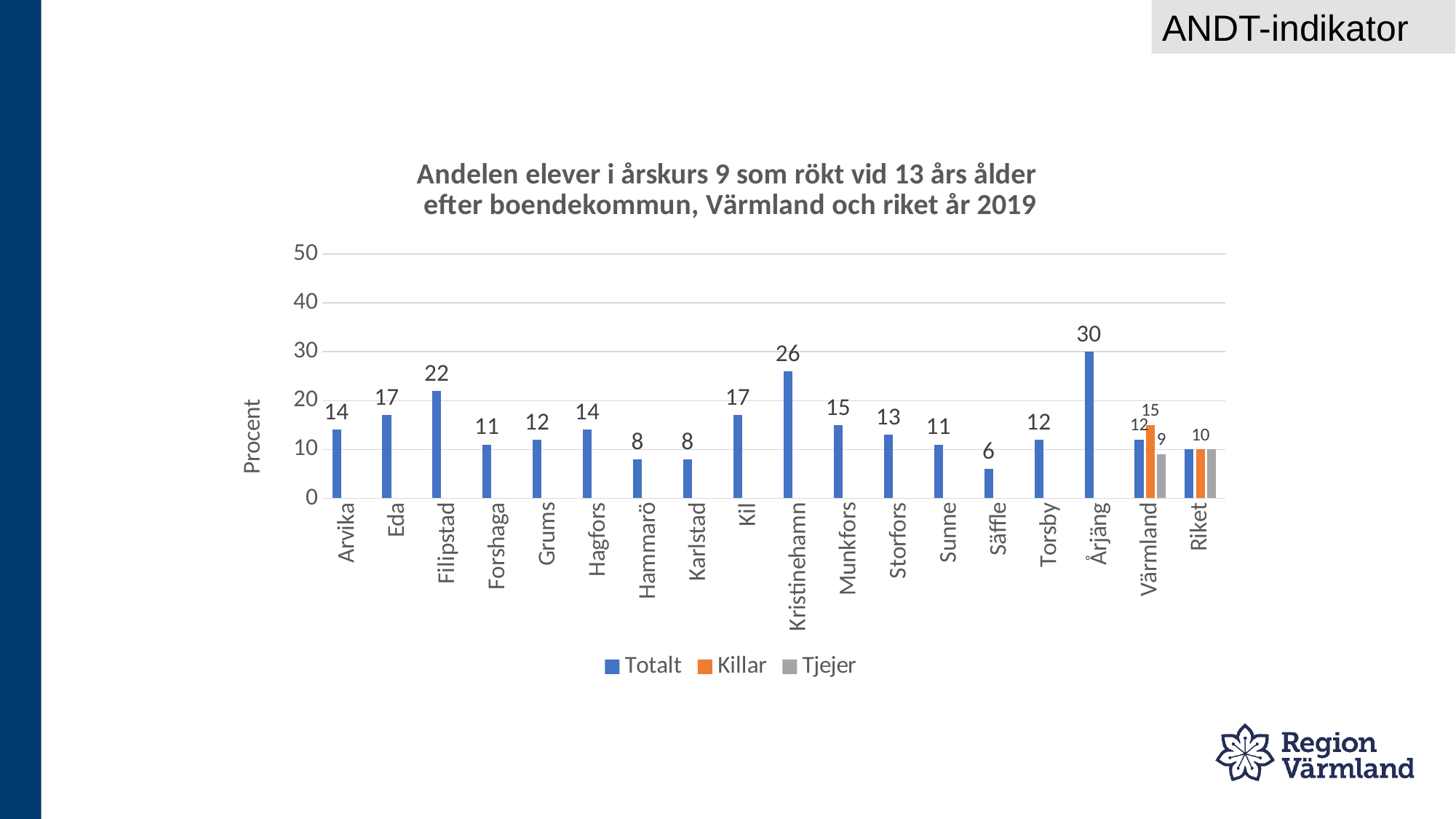
What is the difference between the Totalt values for Filipstad and Forshaga? 11 Which municipality has the lowest Totalt value? Säffle What is the Totalt value for Kristinehamn? 26 What is the Totalt value for Årjäng? 30 What kind of chart is shown on the slide? Bar chart What is the Tjejer value for Värmland? 9 How many categories are shown on the x axis? 18 Which has a higher Totalt value, Eda or Munkfors? Eda Which municipality has the highest Totalt value? Årjäng How many series does the legend list? 3 What is the Killar value for Värmland? 15 Is the Totalt value for Kristinehamn greater or less than 20? greater